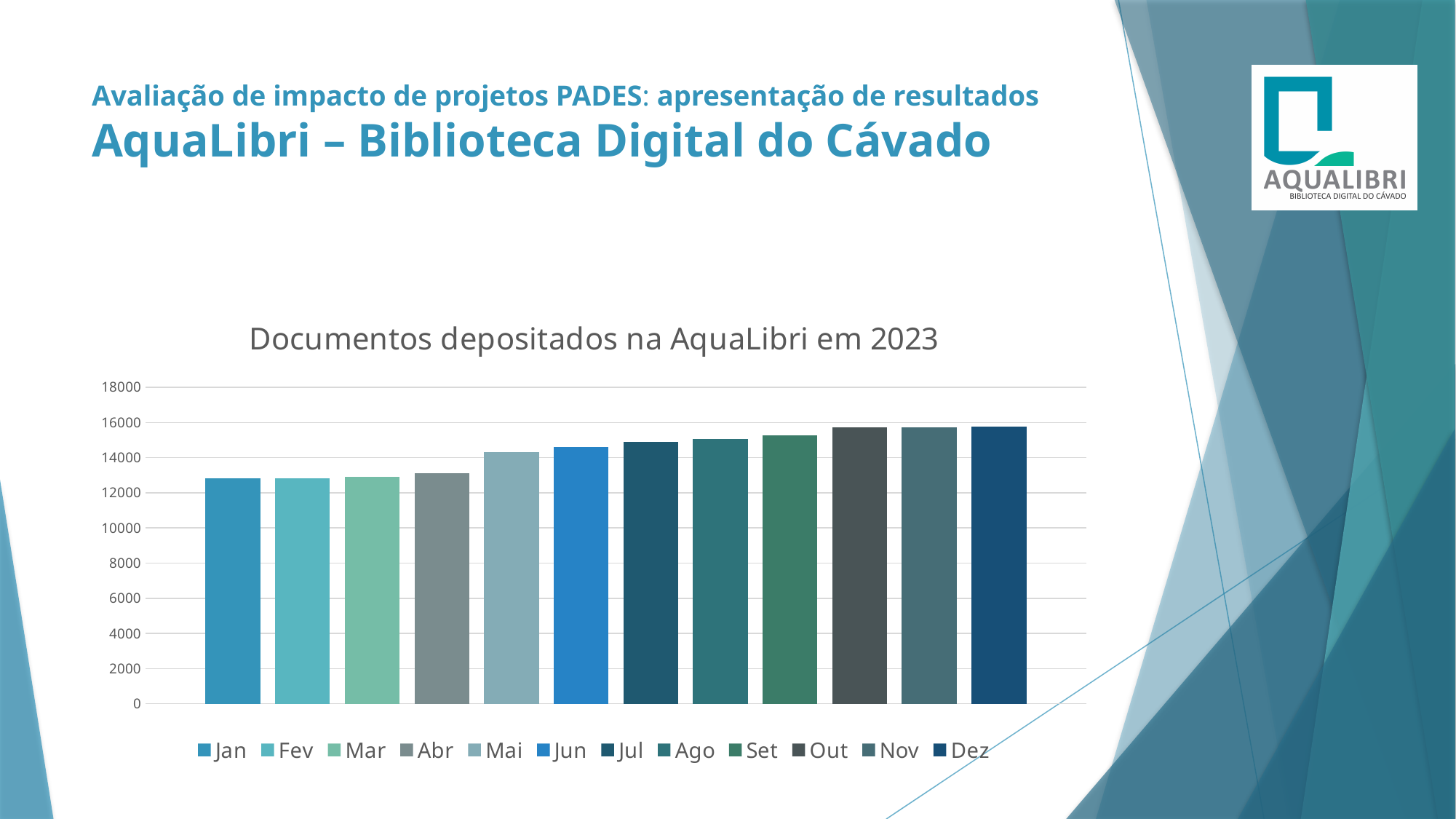
How many entries does the chart legend list? 12 Which is larger, the value for Jan or the value for Jun? Jun Is the value for Abr greater or less than 14000? less Is the value for Dez greater or less than 14000? greater What is the title of the chart? Documentos depositados na AquaLibri em 2023 Is the value for Out greater or less than 16000? less Which is larger, the value for Mar or the value for Set? Set What kind of chart is shown on the slide? bar chart How many bars (months) are plotted in the chart? 12 Do the values generally rise or fall from Jan to Dez? rise